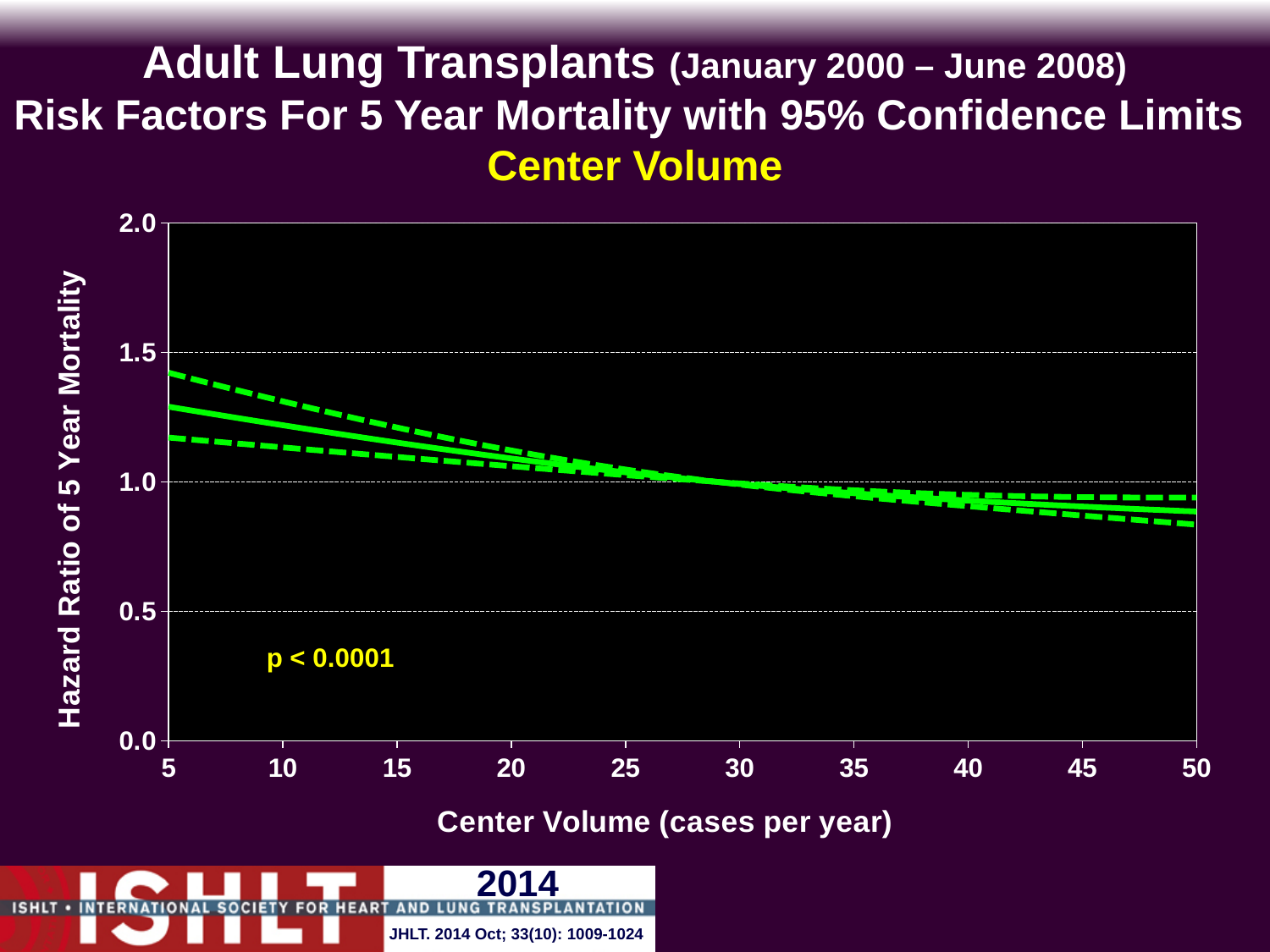
How many lines are plotted on the chart? 3 Which is larger, the hazard ratio (solid line) at a center volume of 5 or at a center volume of 45 cases per year? 5 What is the p-value printed on the chart? p < 0.0001 Is the hazard ratio (solid line) at a center volume of 50 cases per year greater or less than 1.0? less Is the lower 95% confidence limit at a center volume of 50 cases per year greater or less than 0.5? greater What is the label of the x axis? Center Volume (cases per year) Does the hazard ratio of 5 year mortality rise or fall as center volume increases from 5 to 50 cases per year? fall Is the hazard ratio (solid line) at a center volume of 5 cases per year greater or less than 1.0? greater What kind of chart is shown on the slide? line chart